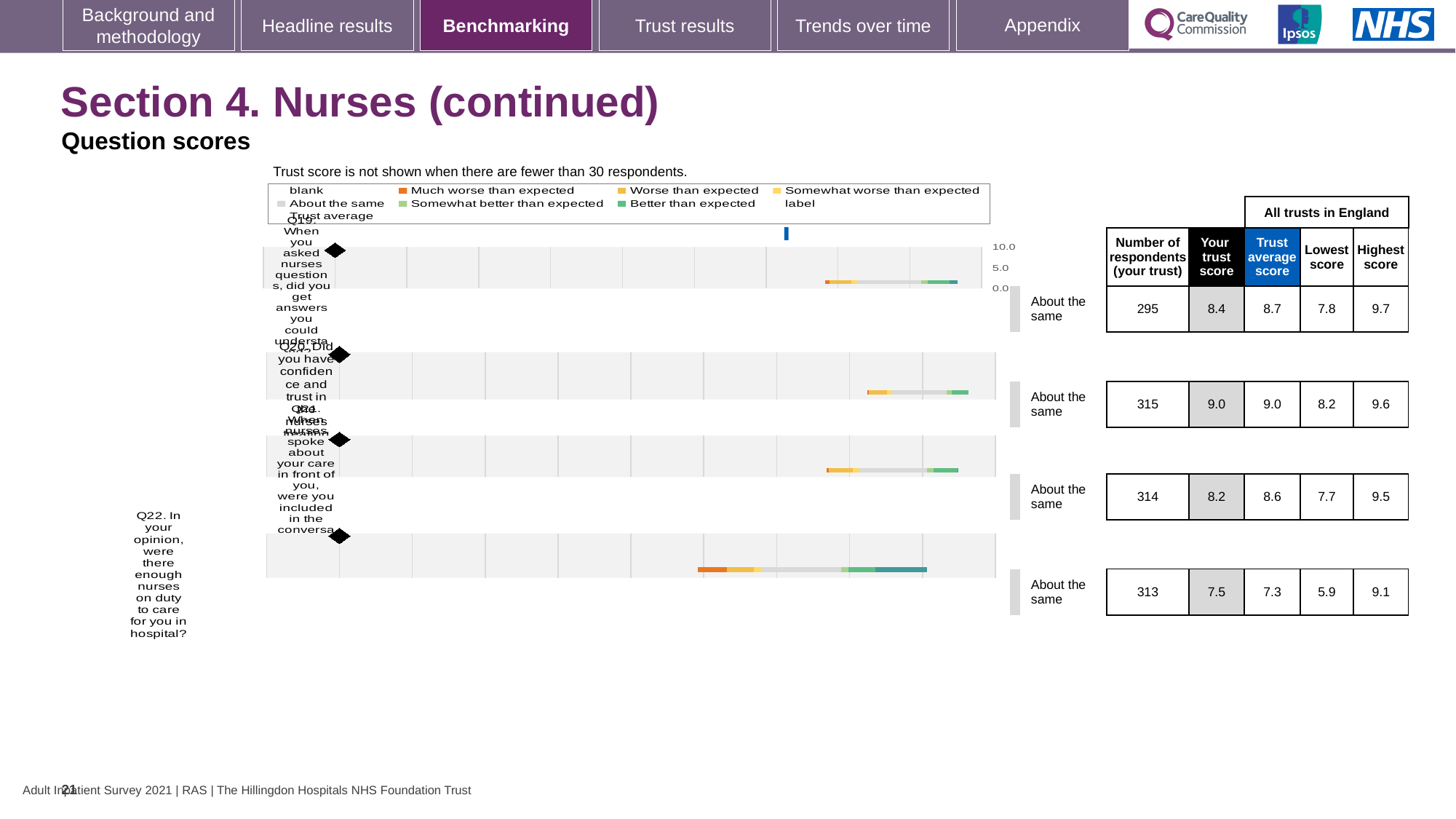
What is the highest score across all trusts in England for Q21? 9.5 How many respondents answered Q20 (Did you have confidence and trust in the nurses treating you)? 315 Is the trust score for Q22 greater or less than 5.0? greater What kind of chart is used to show the question scores? Bar chart What is the difference between the highest score and the lowest score for Q19? 1.9 Which question has the highest 'Your trust score'? Q20 For Q22, which is larger: the trust's own score or the trust average score? Your trust score (7.5) What is the trust score for Q19 (When you asked nurses questions, did you get answers you could understand)? 8.4 Which question has the lowest 'Your trust score'? Q22 What benchmark category is shown for all four questions? About the same How many questions are plotted on the chart? 4 What is the trust average score for Q22 (were there enough nurses on duty to care for you in hospital)? 7.3